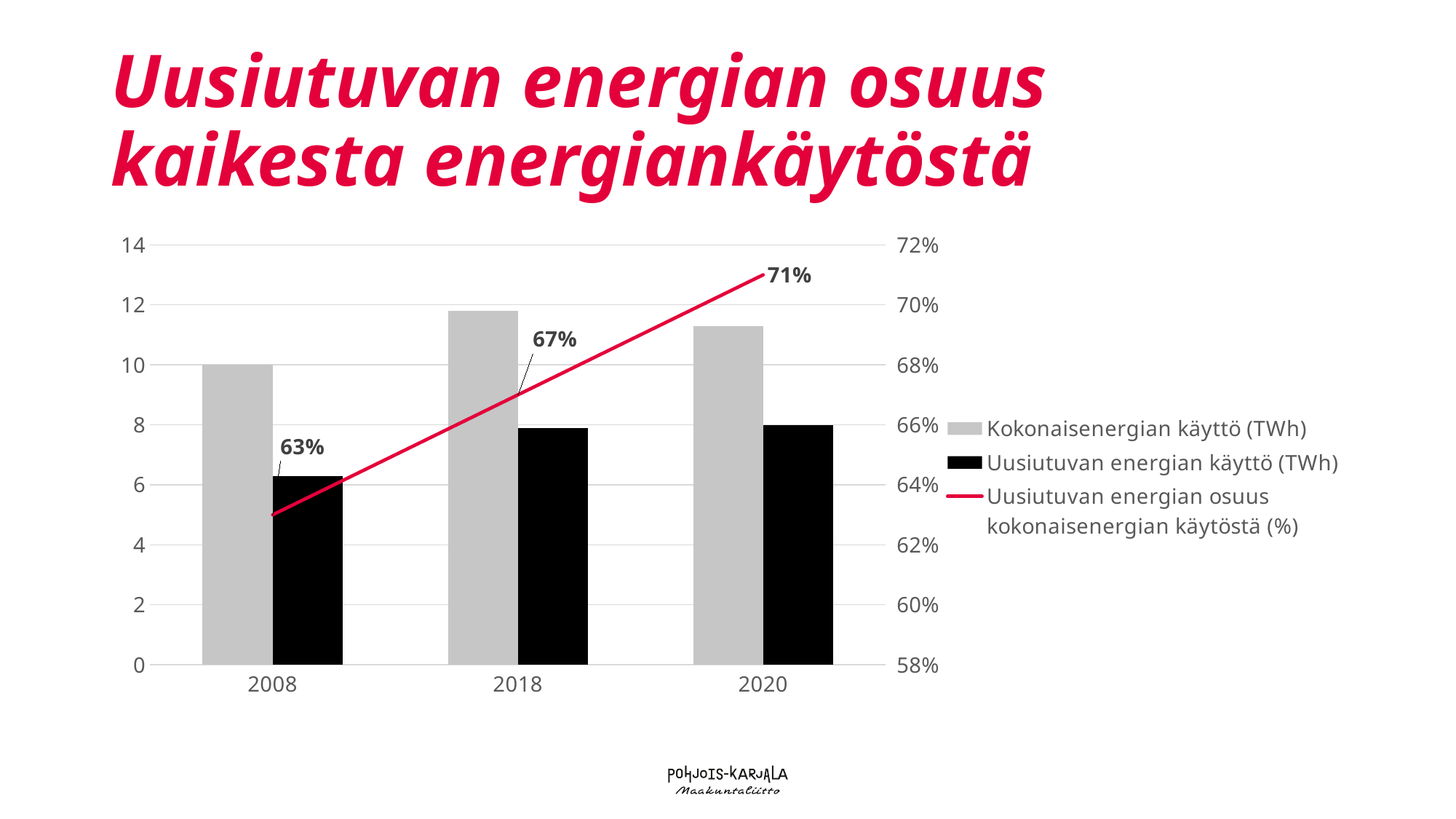
How many series does the legend list? 3 By how many percentage points did Uusiutuvan energian osuus kokonaisenergian käytöstä (%) increase from 2008 to 2020? 8 percentage points Does Uusiutuvan energian osuus kokonaisenergian käytöstä (%) rise or fall from 2008 to 2020? rise What is the value of Uusiutuvan energian osuus kokonaisenergian käytöstä (%) for 2020? 71% Is the value of Uusiutuvan energian käyttö (TWh) for 2008 greater or less than 8? less In which year is Kokonaisenergian käyttö (TWh) highest? 2018 What is the value of Uusiutuvan energian osuus kokonaisenergian käytöstä (%) for 2008? 63% What is the value of Uusiutuvan energian osuus kokonaisenergian käytöstä (%) for 2018? 67% How many years are shown on the x axis? 3 In which year is Uusiutuvan energian osuus kokonaisenergian käytöstä (%) highest? 2020 Is Kokonaisenergian käyttö (TWh) larger in 2018 or in 2020? 2018 In which year is Uusiutuvan energian käyttö (TWh) lowest? 2008